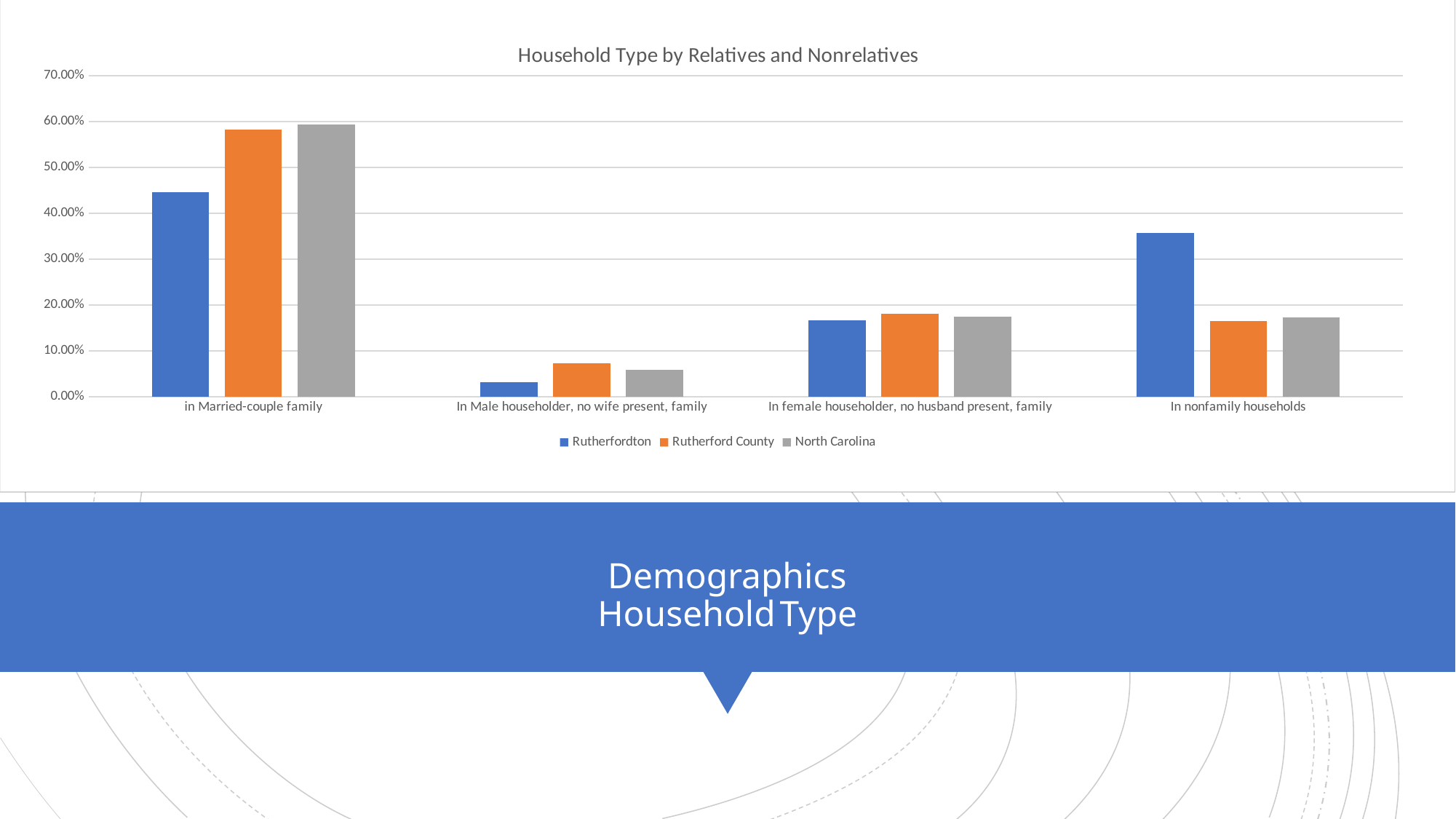
How many household type categories are shown on the x axis? 4 For which category is the Rutherfordton value lowest? In Male householder, no wife present, family Is the Rutherford County value for 'in Married-couple family' greater or less than 50.00%? greater What is the title of the chart? Household Type by Relatives and Nonrelatives Is the Rutherfordton value for 'In nonfamily households' greater or less than 30.00%? greater Is the Rutherfordton value for 'in Married-couple family' greater or less than 40.00%? greater For which category is the Rutherford County value highest? in Married-couple family What kind of chart is shown on the slide? bar chart For 'In nonfamily households', which is larger: the Rutherfordton value or the Rutherford County value? Rutherfordton For 'in Married-couple family', which is larger: the Rutherfordton value or the North Carolina value? North Carolina How many series does the legend list? 3